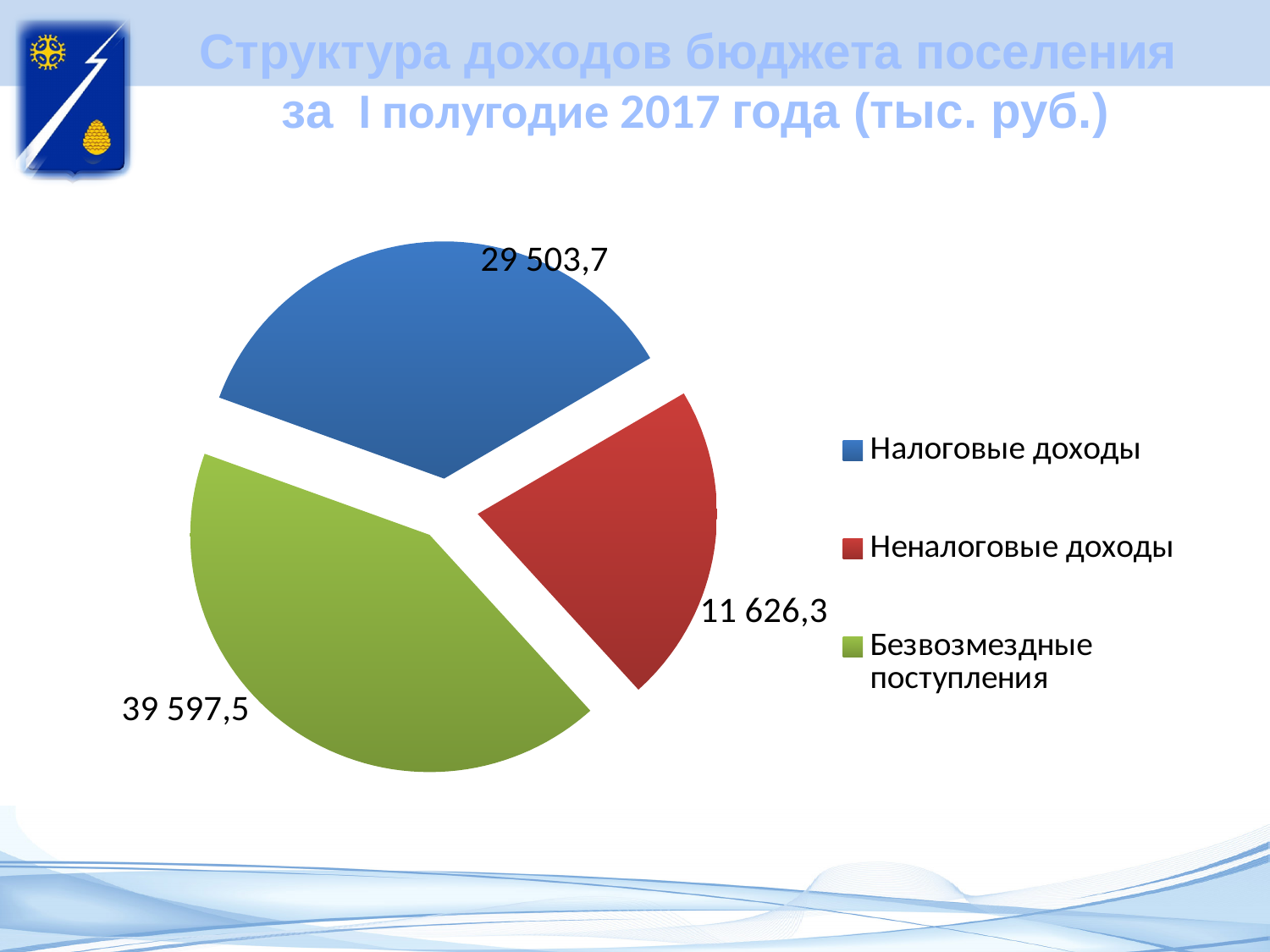
Which category has the smallest slice of the pie? Неналоговые доходы What is the total of all three slices of the pie? 80 727,5 How many categories does the pie chart have? 3 What type of chart is shown on the slide? Pie chart Which category has the largest slice of the pie? Безвозмездные поступления Which is larger, Налоговые доходы or Неналоговые доходы? Налоговые доходы What is the value for Безвозмездные поступления? 39 597,5 What is the difference between Безвозмездные поступления and Налоговые доходы? 10 093,8 What is the value for Налоговые доходы? 29 503,7 What colour is the slice for Безвозмездные поступления? Green What is the difference between Налоговые доходы and Неналоговые доходы? 17 877,4 What is the value for Неналоговые доходы? 11 626,3